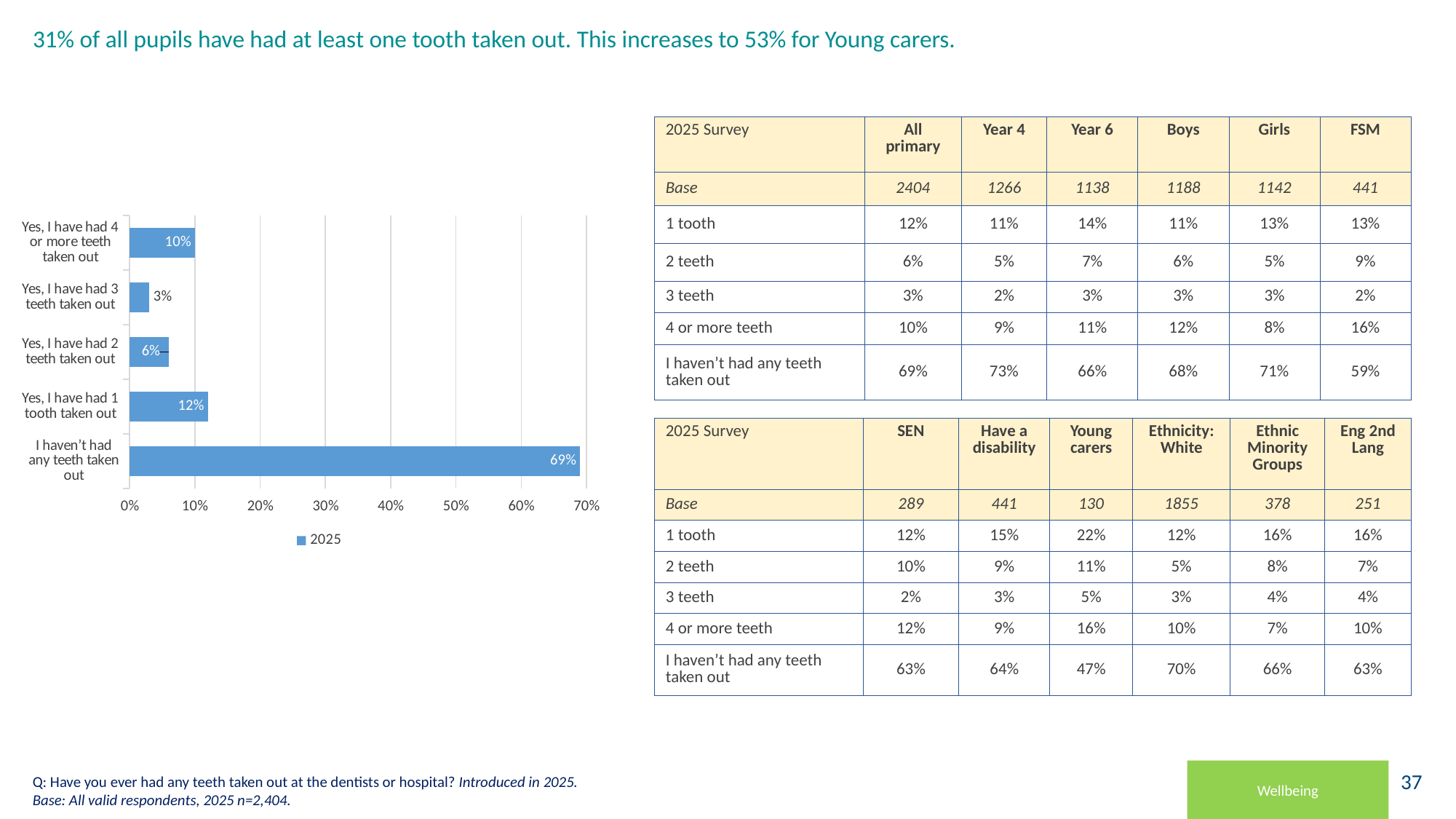
Which category has the highest value in the chart? I haven't had any teeth taken out What kind of chart is shown on the slide? bar chart How many categories are shown in the chart? 5 Which category has the lowest value in the chart? Yes, I have had 3 teeth taken out What is the value for 'Yes, I have had 4 or more teeth taken out'? 10% Is the value for 'I haven't had any teeth taken out' greater or less than 60%? greater What is the difference between the value for 'I haven't had any teeth taken out' and 'Yes, I have had 1 tooth taken out'? 57% Which is larger: the value for 4 or more teeth taken out or the value for 2 teeth taken out? 4 or more teeth taken out What is the value for 'Yes, I have had 3 teeth taken out'? 3% What percentage of pupils said they haven't had any teeth taken out? 69% What is the value for 'Yes, I have had 1 tooth taken out'? 12% How many series does the legend list? 1